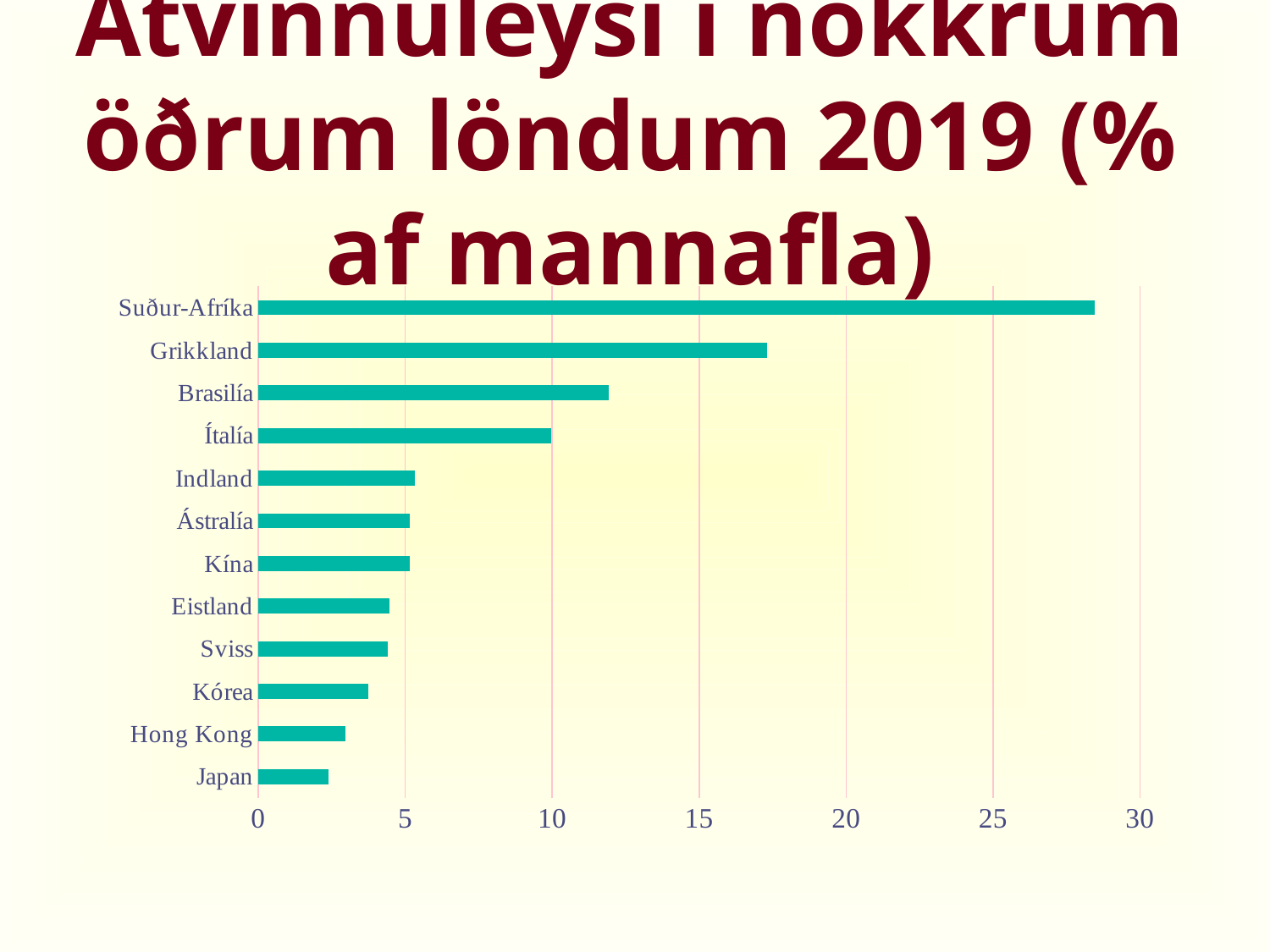
How many countries are shown in the chart? 12 Which has a higher unemployment rate, Hong Kong or Japan? Hong Kong What year does the chart title say the unemployment data is for? 2019 Which has a higher unemployment rate, Grikkland or Brasilía? Grikkland Which country has the highest unemployment rate in the chart? Suður-Afríka Is the value for Japan greater or less than 5? less Is the value for Brasilía greater or less than 10? greater What kind of chart is shown on the slide? bar chart Which country has the lowest unemployment rate in the chart? Japan Is the value for Suður-Afríka greater or less than 25? greater